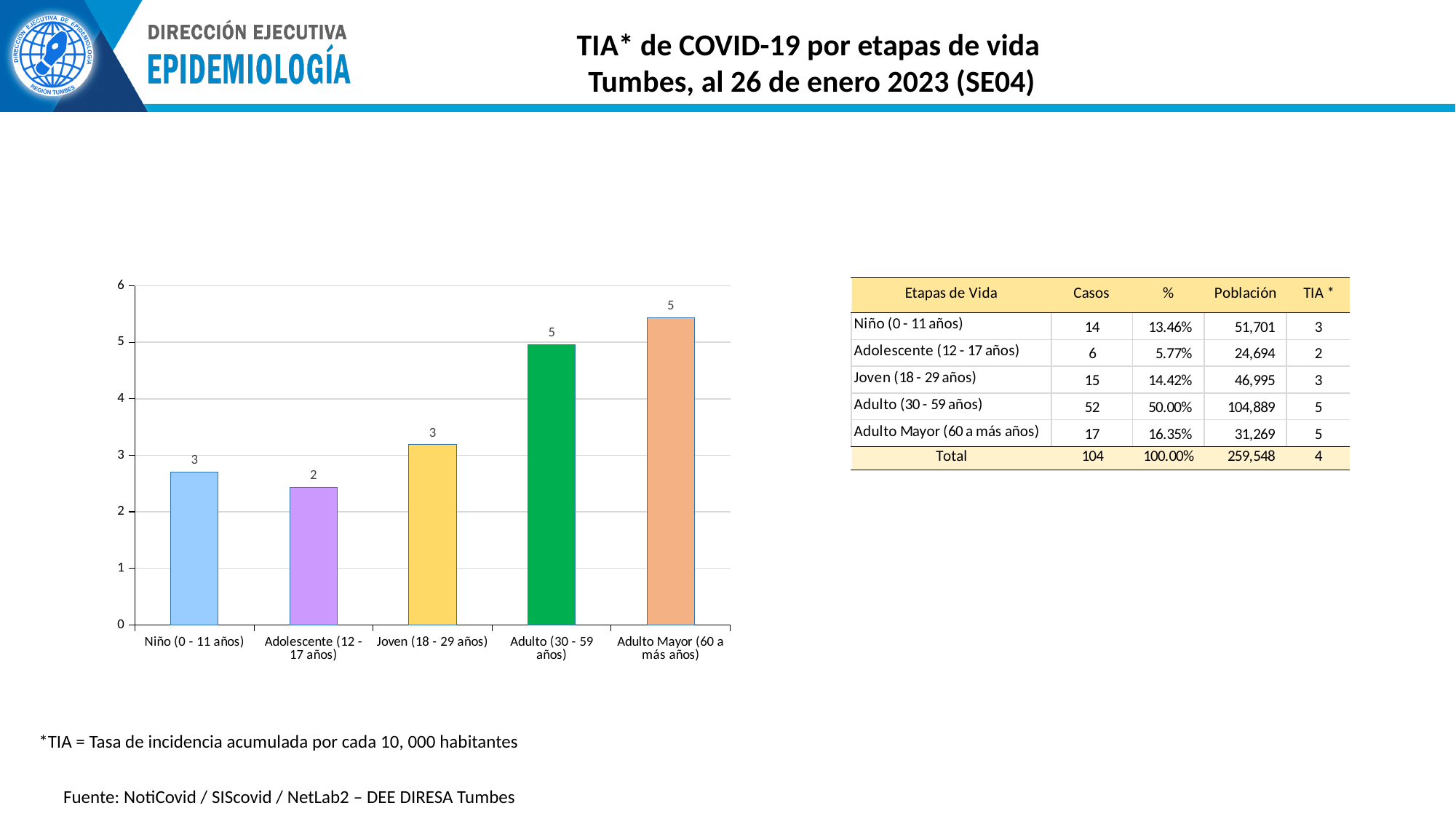
Which life stage has the tallest bar in the chart? Adulto Mayor (60 a más años) Which life stage has the lowest TIA in the bar chart? Adolescente (12 - 17 años) Do the TIA values generally rise or fall from Niño to Adulto Mayor along the x axis? rise Is the bar for Adulto (30 - 59 años) greater or less than 4? greater What is the TIA value shown for Adulto (30 - 59 años) in the bar chart? 5 Is the bar for Niño (0 - 11 años) greater or less than 4? less Which has a higher TIA in the chart, Adulto (30 - 59 años) or Niño (0 - 11 años)? Adulto (30 - 59 años) What is the TIA value shown for Joven (18 - 29 años) in the bar chart? 3 What is the TIA value shown for Adolescente (12 - 17 años) in the bar chart? 2 What type of chart is used to show the TIA by life stage? bar chart How many life-stage categories are plotted in the bar chart? 5 What is the difference between the TIA labels for Adulto (30 - 59 años) and Adolescente (12 - 17 años)? 3